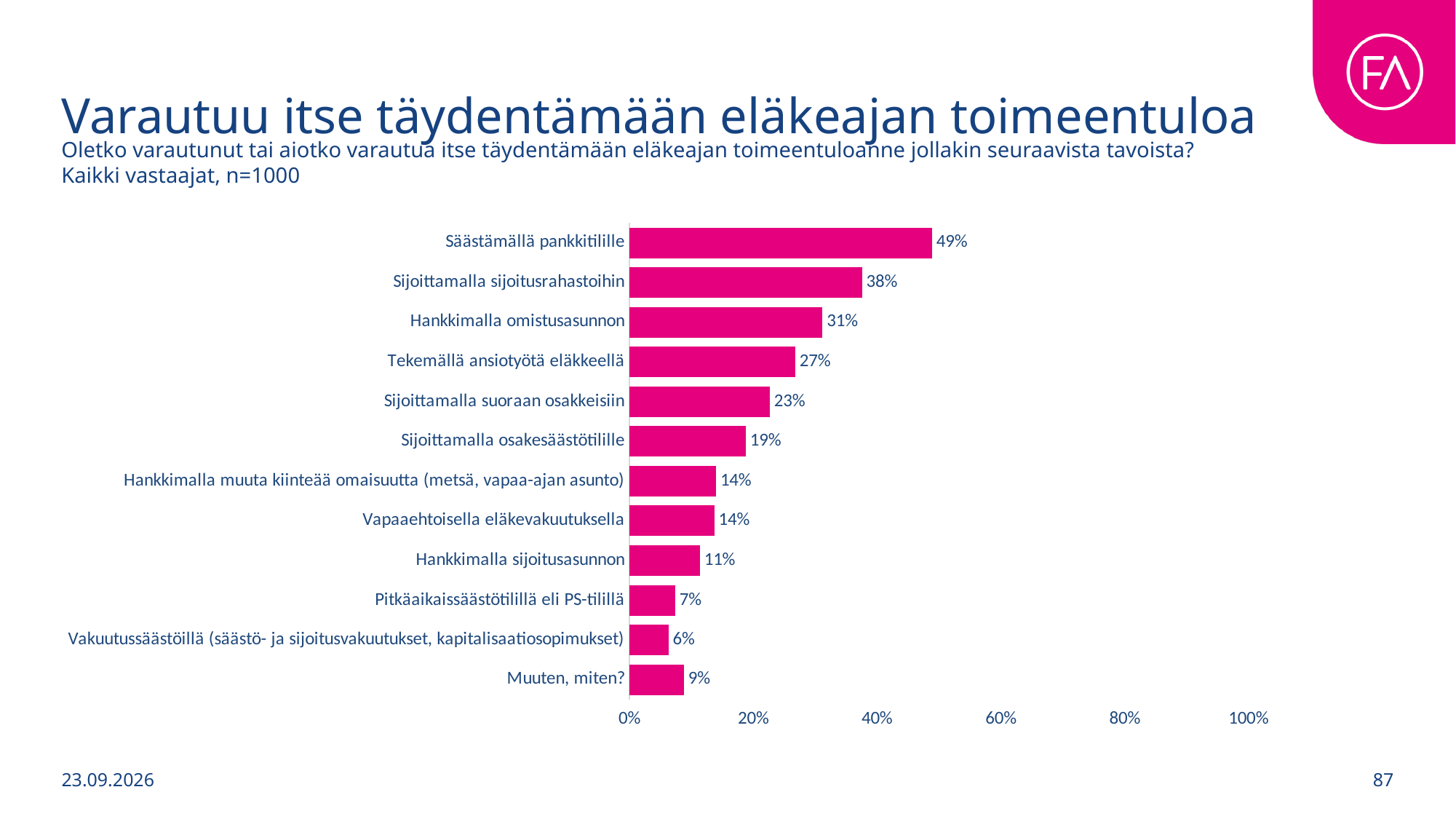
What is the value for Hankkimalla sijoitusasunnon? 11% What is the sample size stated on the slide? n=1000 Which category has the highest value? Säästämällä pankkitilille Which is larger, Tekemällä ansiotyötä eläkkeellä or Sijoittamalla suoraan osakkeisiin? Tekemällä ansiotyötä eläkkeellä What is the value for Sijoittamalla sijoitusrahastoihin? 38% What kind of chart is shown on the slide? Bar chart What is the value for Muuten, miten? 9% How many categories are shown in the chart? 12 What is the value for Säästämällä pankkitilille? 49% Is the value for Hankkimalla omistusasunnon greater or less than 20%? greater Which category has the lowest value? Vakuutussäästöillä (säästö- ja sijoitusvakuutukset, kapitalisaatiosopimukset) What is the difference between Säästämällä pankkitilille and Sijoittamalla sijoitusrahastoihin? 11 percentage points